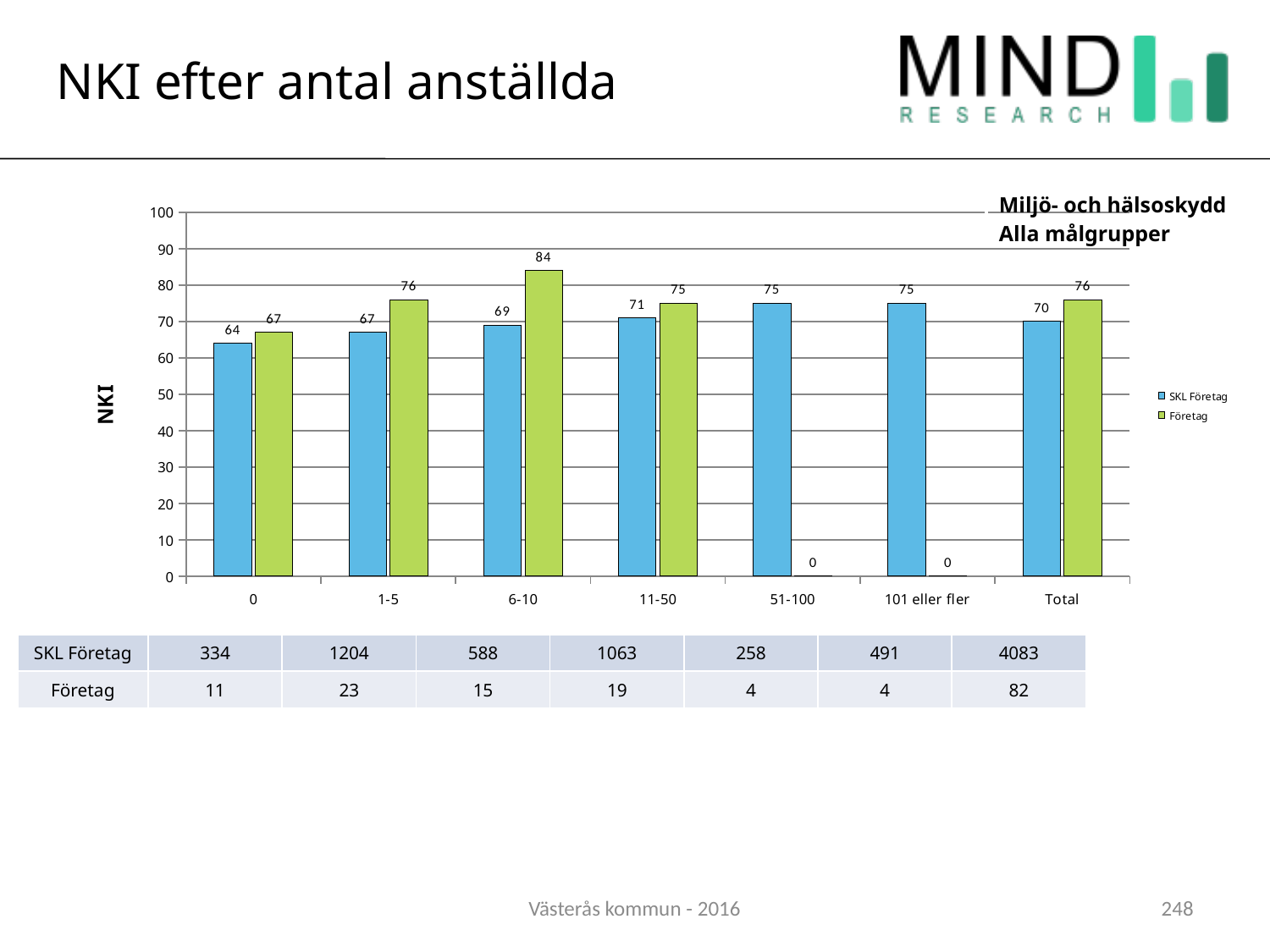
What is the difference between the Företag and SKL Företag values in the 6-10 category? 15 What is the NKI value for SKL Företag in the 6-10 category? 69 Which category has the lowest NKI value for the SKL Företag series? 0 What is the NKI value for Företag in the Total category? 76 What is the NKI value for Företag in the 51-100 category? 0 In the 11-50 category, which series has the higher NKI value, SKL Företag or Företag? Företag What kind of chart is shown on the slide? Bar chart How many series does the legend list? 2 How many categories are shown on the x axis? 7 Which category has the highest NKI value for the Företag series? 6-10 What is the label on the vertical axis of the chart? NKI What is the NKI value for Företag in the 1-5 category? 76